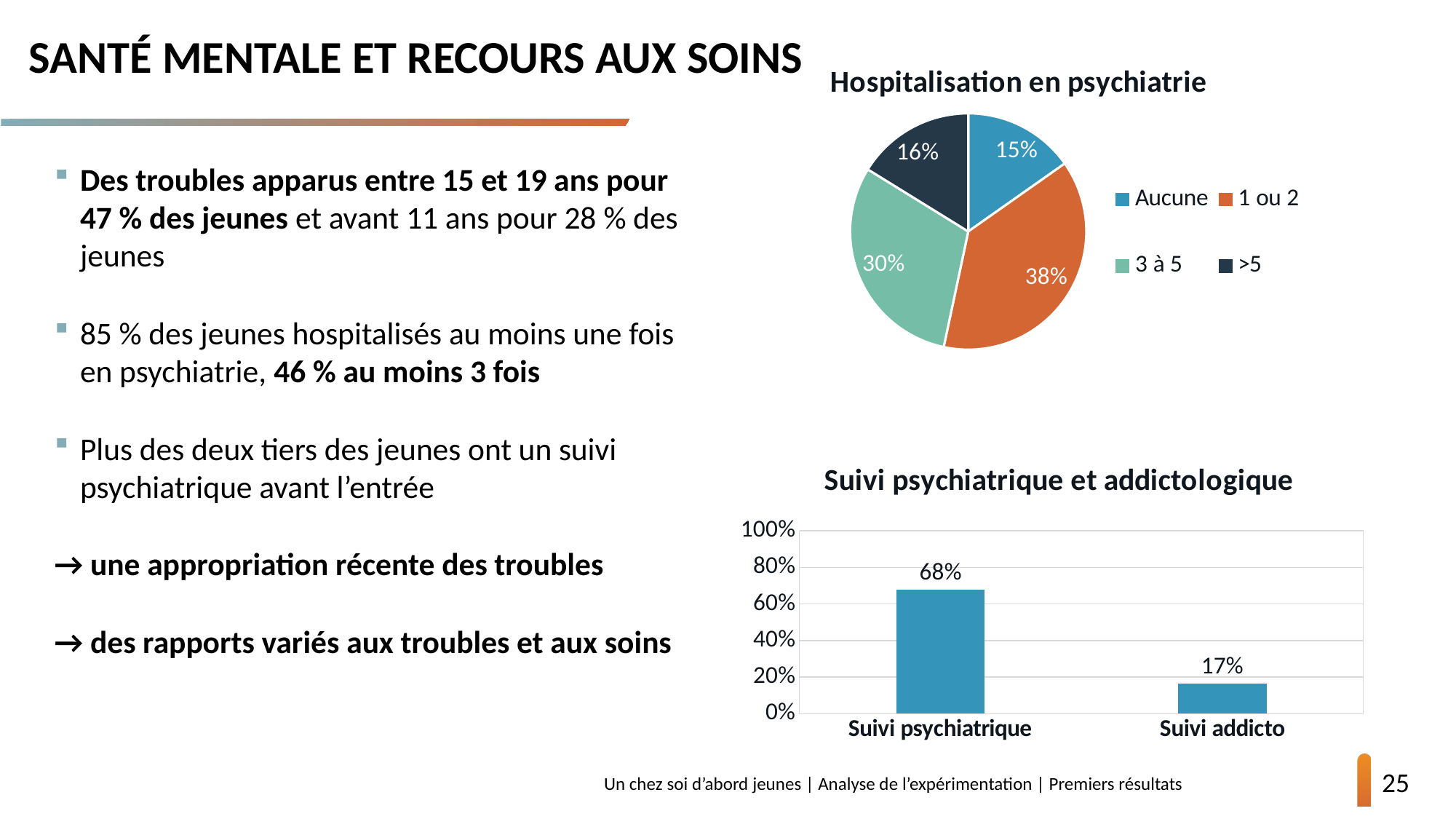
In the 'Hospitalisation en psychiatrie' pie chart, how many categories does the legend list? 4 What kind of chart is 'Suivi psychiatrique et addictologique'? Bar chart In the 'Hospitalisation en psychiatrie' pie chart, which category has the smallest slice? Aucune In the 'Hospitalisation en psychiatrie' pie chart, what share is shown for '3 à 5'? 30% In the 'Hospitalisation en psychiatrie' pie chart, which category has the largest slice? 1 ou 2 In the 'Suivi psychiatrique et addictologique' chart, what is the value for 'Suivi psychiatrique'? 68% In the 'Hospitalisation en psychiatrie' pie chart, what share is shown for '1 ou 2'? 38% In the 'Suivi psychiatrique et addictologique' chart, what is the value for 'Suivi addicto'? 17% In the 'Hospitalisation en psychiatrie' pie chart, what share is shown for 'Aucune'? 15% What kind of chart is 'Hospitalisation en psychiatrie'? Pie chart In the 'Hospitalisation en psychiatrie' pie chart, what is the difference between the '3 à 5' share and the '>5' share? 14 percentage points In the 'Suivi psychiatrique et addictologique' chart, what is the difference between 'Suivi psychiatrique' and 'Suivi addicto'? 51 percentage points